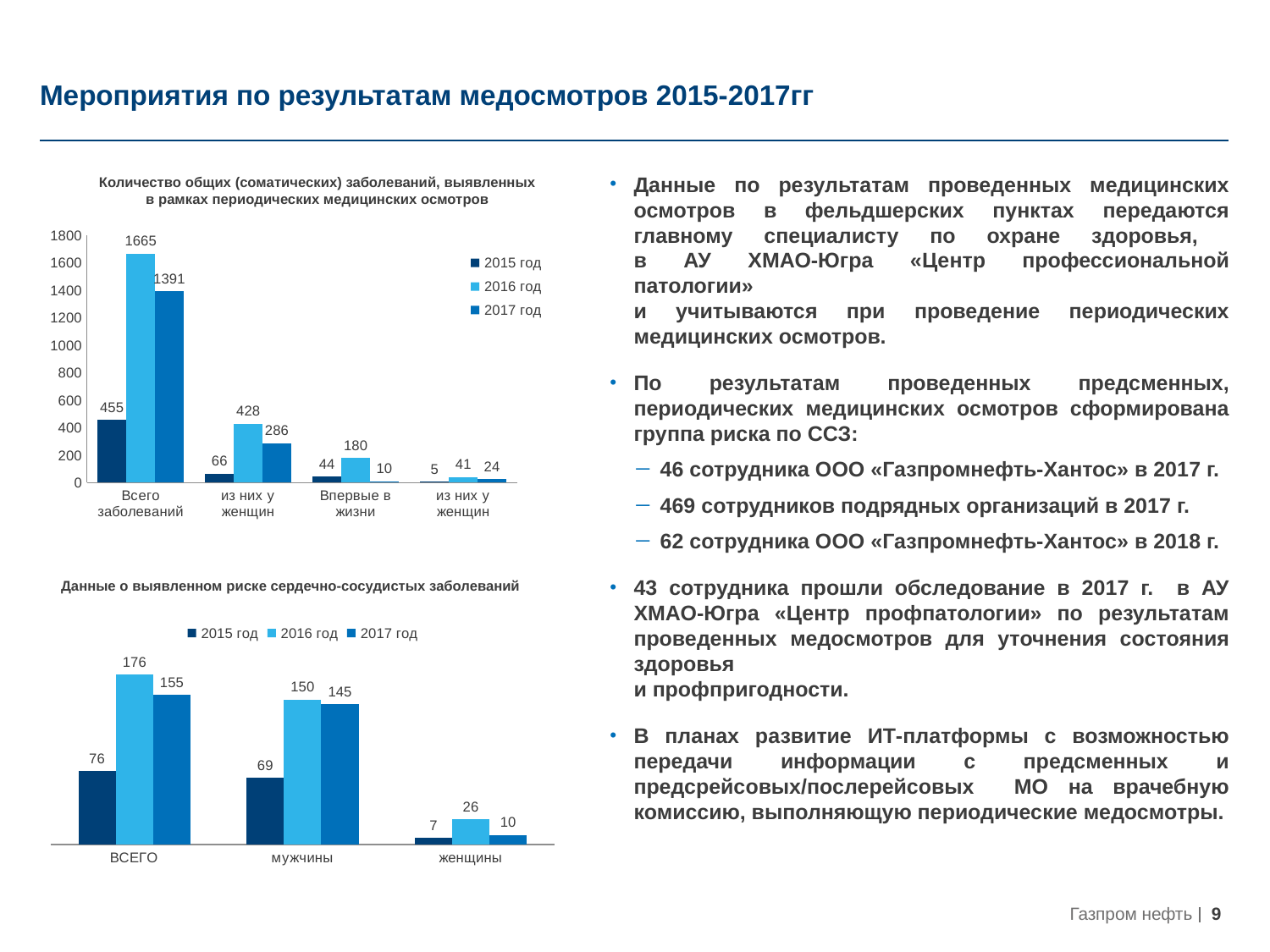
In the bottom chart (Данные о выявленном риске сердечно-сосудистых заболеваний), what is the value for женщины in 2015 год? 7 In the top chart (Количество общих (соматических) заболеваний), what is the difference between the 2016 год and 2017 год values for Всего заболеваний? 274 In the top chart (Количество общих (соматических) заболеваний), what is the value for Всего заболеваний in 2016 год? 1665 In the top chart (Количество общих (соматических) заболеваний), how many categories are shown on the x axis? 4 In the top chart (Количество общих (соматических) заболеваний), what is the value for Всего заболеваний in 2015 год? 455 In the bottom chart (Данные о выявленном риске сердечно-сосудистых заболеваний), which is larger for ВСЕГО: the 2015 год value or the 2017 год value? 2017 год In the bottom chart (Данные о выявленном риске сердечно-сосудистых заболеваний), what is the value for мужчины in 2016 год? 150 In the top chart (Количество общих (соматических) заболеваний), how many series does the legend list? 3 In the bottom chart (Данные о выявленном риске сердечно-сосудистых заболеваний), which category has the lowest value in 2017 год? женщины What kind of chart is the bottom chart (Данные о выявленном риске сердечно-сосудистых заболеваний)? Bar chart In the top chart (Количество общих (соматических) заболеваний), what is the value for Впервые в жизни in 2017 год? 10 In the top chart (Количество общих (соматических) заболеваний), which year has the highest value for Всего заболеваний? 2016 год